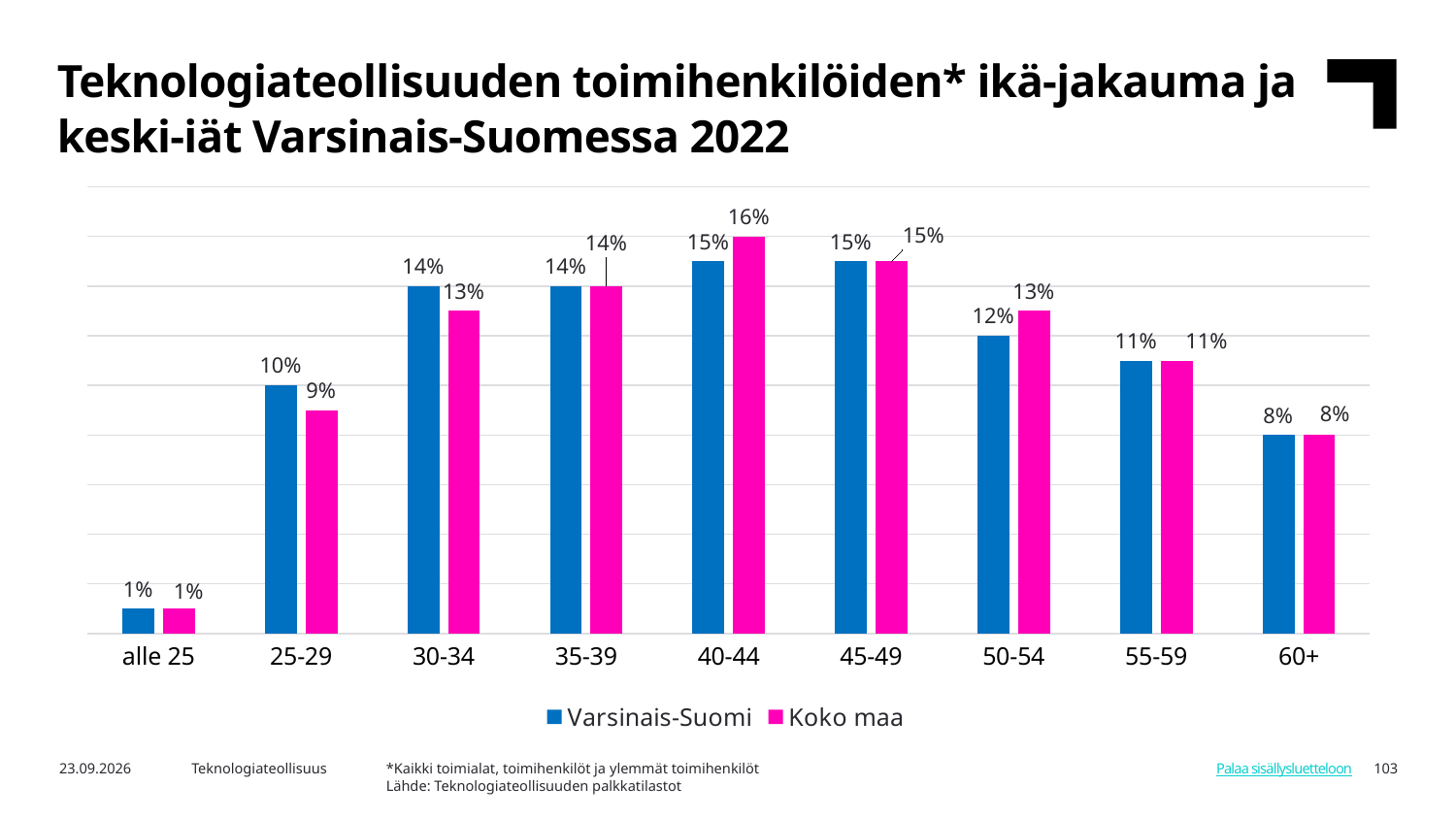
Which series is shown in pink in the legend? Koko maa How many age categories are shown on the x axis? 9 Which age group has the highest value for Koko maa? 40-44 Which age group has the lowest value for Varsinais-Suomi? alle 25 What is the value for Varsinais-Suomi in the 50-54 age group? 12% What is the value for Varsinais-Suomi in the 25-29 age group? 10% In the 50-54 age group, which series has the larger value, Varsinais-Suomi or Koko maa? Koko maa What is the difference between Varsinais-Suomi and Koko maa in the 25-29 age group? 1% What is the value for Koko maa in the 40-44 age group? 16% Do the Varsinais-Suomi values rise or fall from the 45-49 age group to the 60+ age group? fall What kind of chart is shown on the slide? bar chart How many series does the legend list? 2